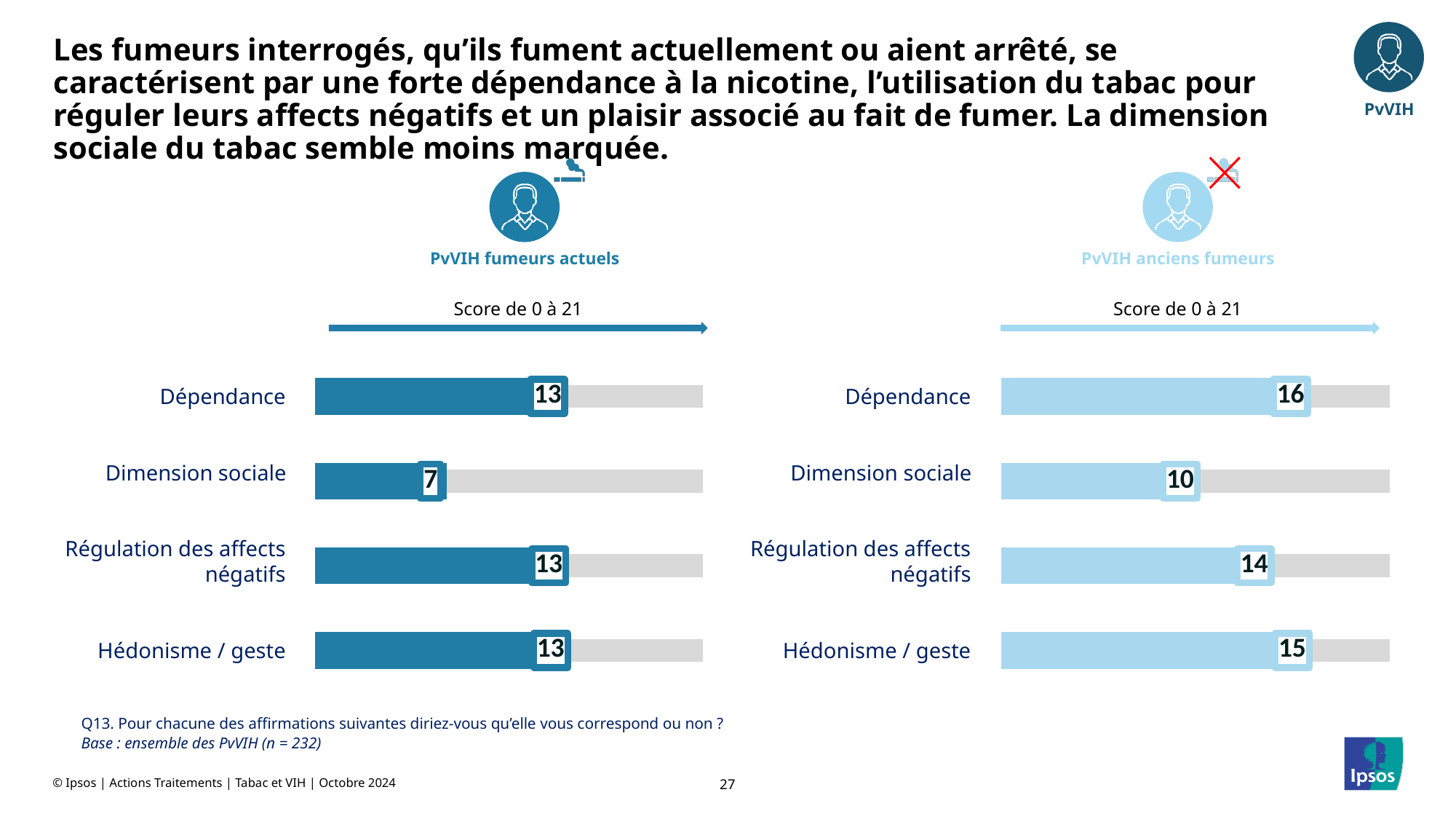
In the 'PvVIH anciens fumeurs' chart, which category has the highest score? Dépendance What score range is indicated above each chart? Score de 0 à 21 In the 'PvVIH anciens fumeurs' chart, what is the difference between the scores for Dépendance and Dimension sociale? 6 In the 'PvVIH anciens fumeurs' chart, what is the score for Dépendance? 16 In the 'PvVIH anciens fumeurs' chart, which category has the lowest score? Dimension sociale In the 'PvVIH fumeurs actuels' chart, what is the score for Dimension sociale? 7 In the 'PvVIH anciens fumeurs' chart, what is the score for Hédonisme / geste? 15 How many categories are shown in the 'PvVIH fumeurs actuels' chart? 4 What type of chart is used for the 'PvVIH anciens fumeurs' data? Bar chart In the 'PvVIH fumeurs actuels' chart, what is the score for Régulation des affects négatifs? 13 Which is larger: the Dimension sociale score in the 'PvVIH fumeurs actuels' chart or in the 'PvVIH anciens fumeurs' chart? PvVIH anciens fumeurs In the 'PvVIH fumeurs actuels' chart, which category has the lowest score? Dimension sociale